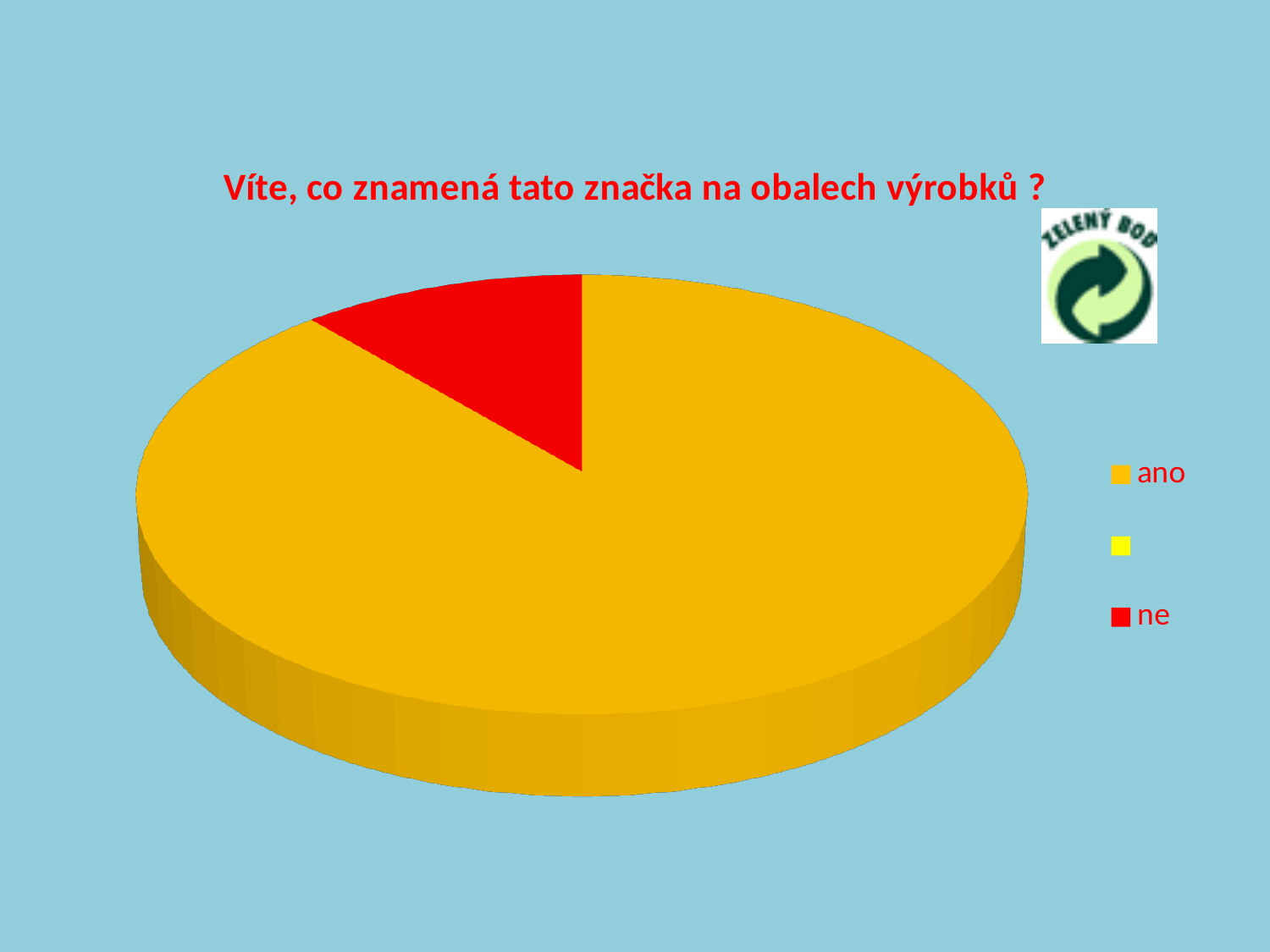
Which category has the largest slice of the pie? ano What kind of chart is shown on the slide? pie chart How many slices are visible in the pie? 2 Which slice is larger, "ano" or "ne"? ano Does the "ano" slice take up more or less than half of the pie? more What colour is the "ano" slice? orange What is the title of the chart? Víte, co znamená tato značka na obalech výrobků ? Which labelled category has the smallest visible slice of the pie? ne Does the "ne" slice take up more or less than half of the pie? less